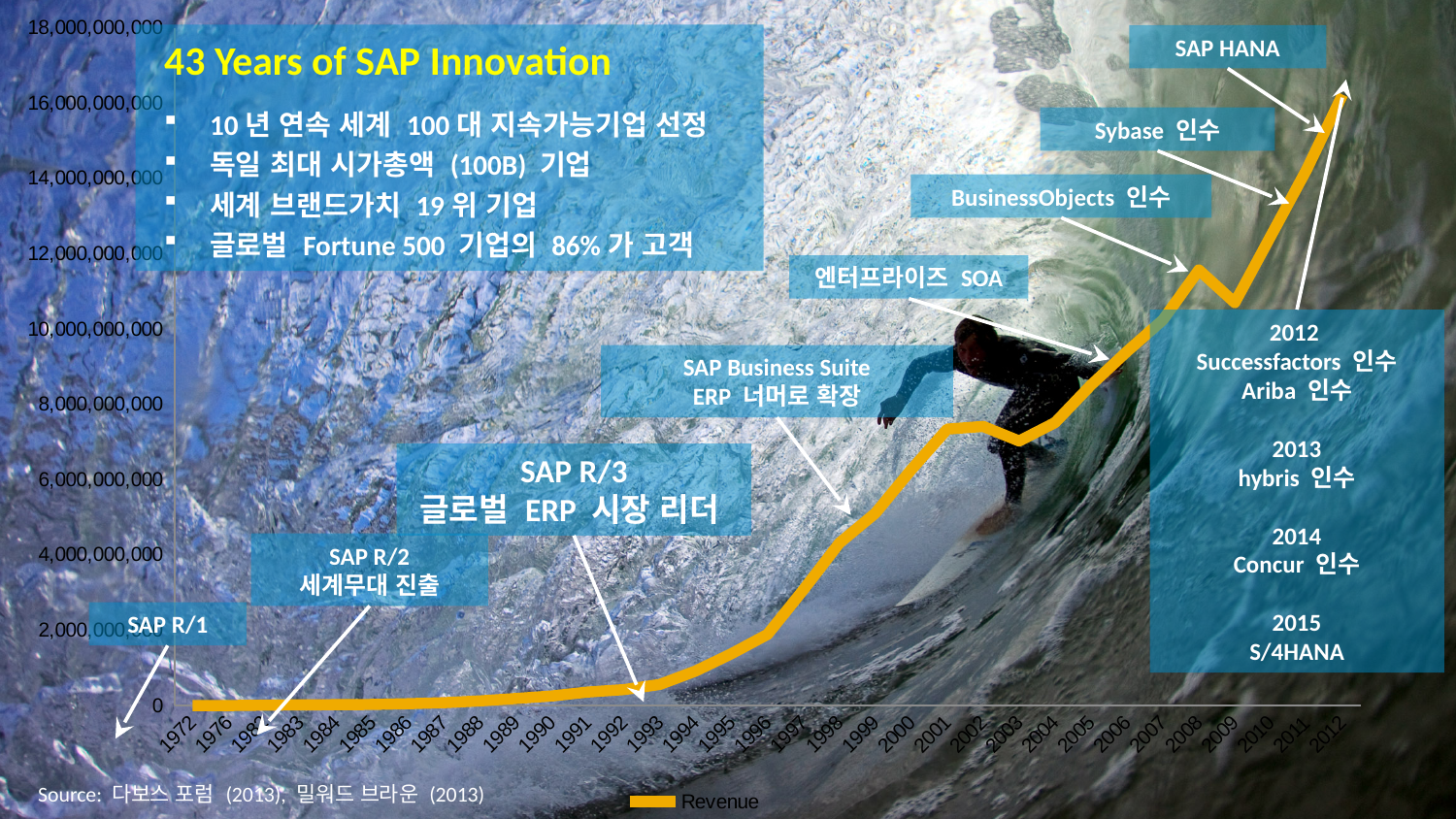
Does the revenue generally rise or fall from 1972 to 2012? rise Is the revenue value for 2008 greater or less than 10,000,000,000? greater What is the name of the series shown in the chart legend? Revenue Which year has the lowest revenue value in the chart? 1972 What kind of chart is shown on the slide? line chart What is the title shown on the slide above the chart? 43 Years of SAP Innovation Is the revenue value for 2012 greater or less than 14,000,000,000? greater Is the revenue value for 1993 greater or less than 2,000,000,000? less Which year has the highest revenue value in the chart? 2012 How many series does the chart legend list? 1 Which year has the larger revenue value, 2007 or 2008? 2008 How many year labels are shown on the x axis of the chart? 33